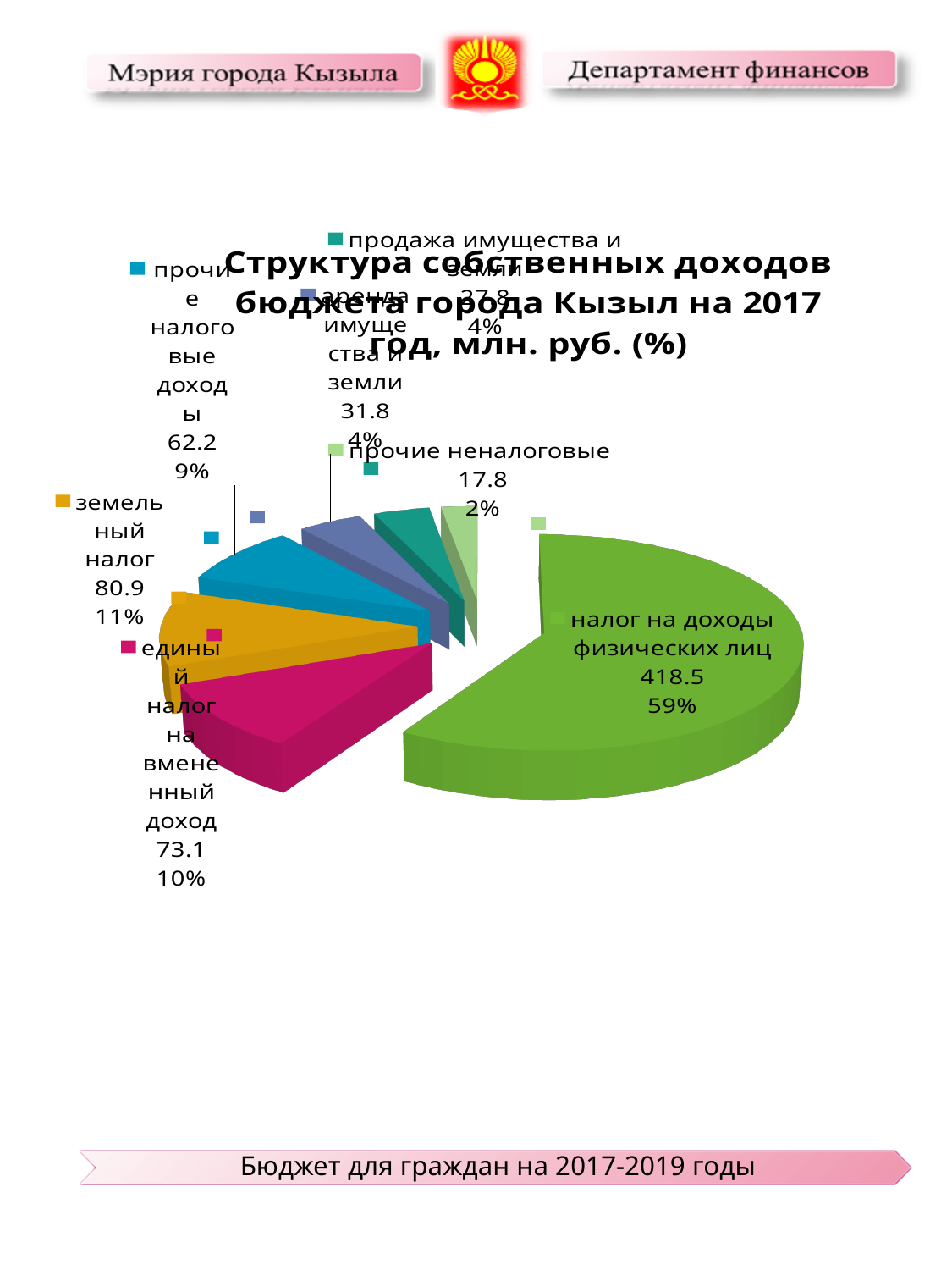
What is the value for единый налог на вмененный доход? 73.1 What kind of chart is shown on the slide? pie chart What share of the pie does налог на доходы физических лиц represent? 59% What is the value for прочие налоговые доходы? 62.2 What is the value for прочие неналоговые? 17.8 What is the value for налог на доходы физических лиц? 418.5 What is the difference between земельный налог and единый налог на вмененный доход? 7.8 Which category has the largest value? налог на доходы физических лиц How many categories are shown in the pie chart? 7 What is the value for земельный налог? 80.9 Which category has the smallest value? прочие неналоговые What share of the pie does аренда имущества и земли represent? 4%